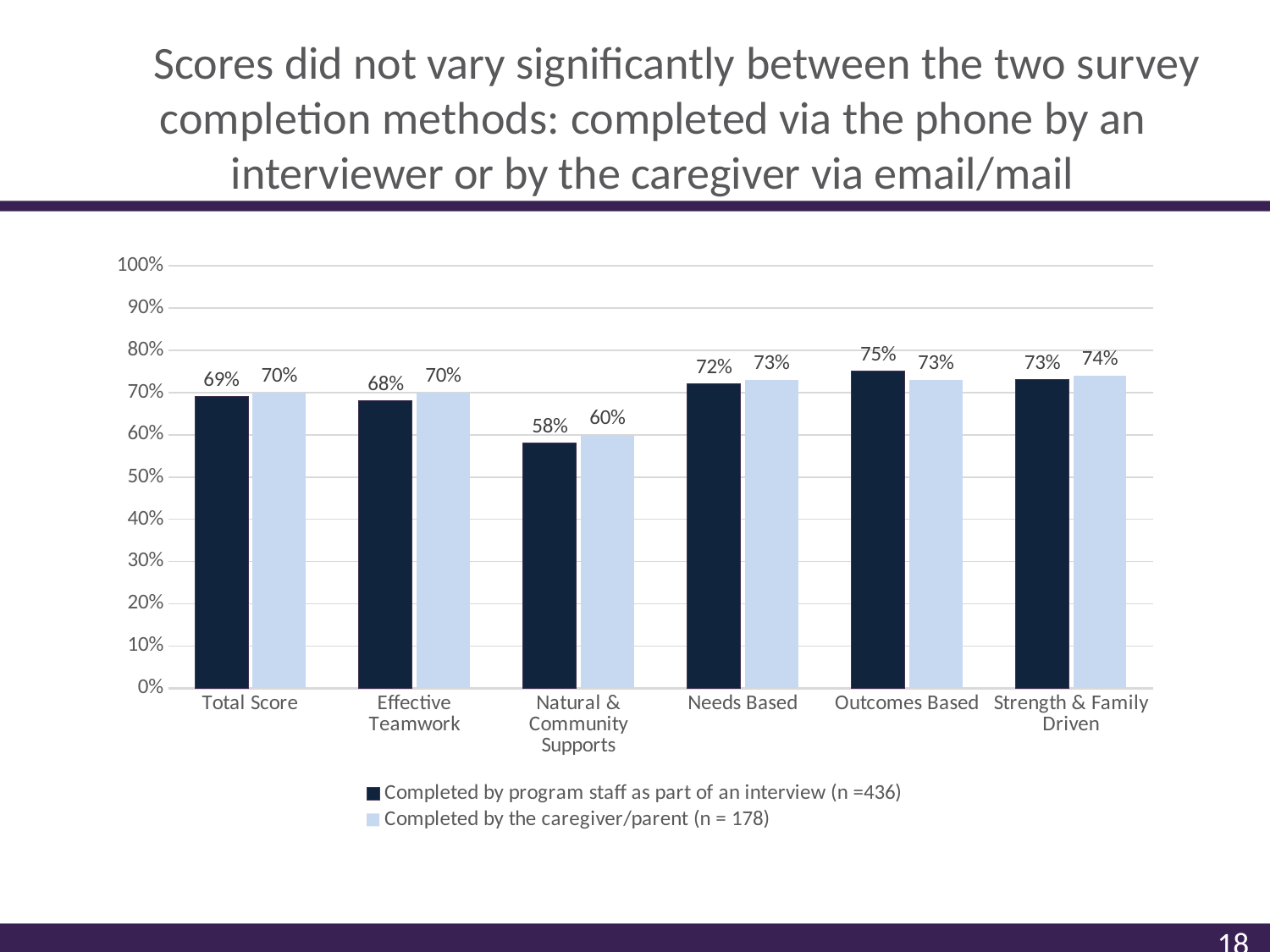
Which category has the lowest value in the 'Completed by program staff as part of an interview (n =436)' series? Natural & Community Supports What is the difference between the Outcomes Based and Natural & Community Supports values in the 'Completed by program staff as part of an interview (n =436)' series? 17% For Outcomes Based, which series has the larger value? Completed by program staff as part of an interview (n =436) Is the value for Needs Based in the 'Completed by the caregiver/parent (n = 178)' series greater or less than 70%? greater Which category has the highest value in the 'Completed by the caregiver/parent (n = 178)' series? Strength & Family Driven How many categories are shown on the x axis? 6 What is the value for Natural & Community Supports in the 'Completed by the caregiver/parent (n = 178)' series? 60% What is the value for Outcomes Based in the 'Completed by program staff as part of an interview (n =436)' series? 75% What kind of chart is shown on the slide? Bar chart What is the difference between the two series' values for Natural & Community Supports? 2% How many series does the legend list? 2 What is the value for Total Score in the 'Completed by program staff as part of an interview (n =436)' series? 69%